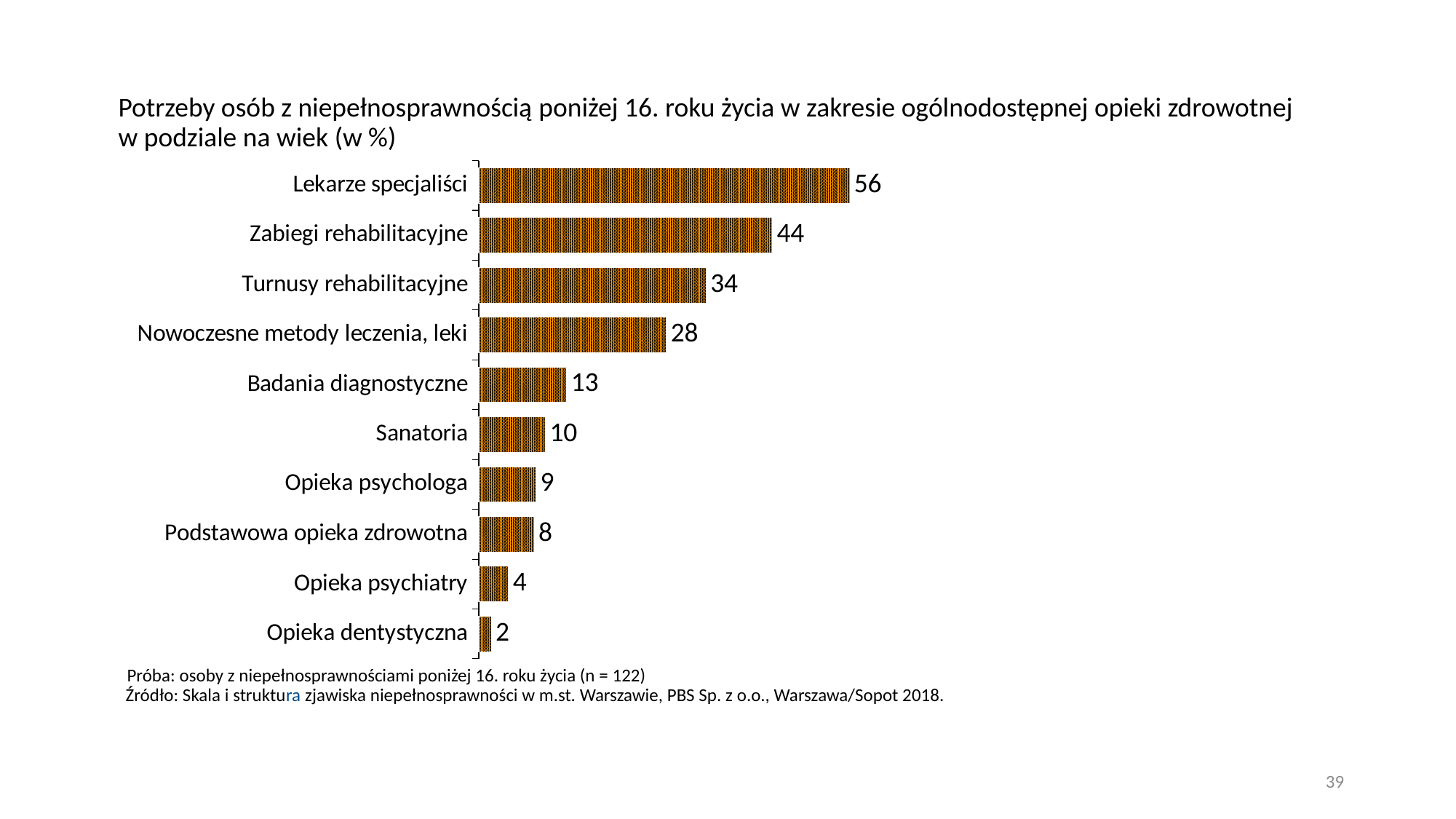
What is the sample size (n) given in the note below the chart? 122 Which category has the lowest value? Opieka dentystyczna What is the value for Nowoczesne metody leczenia, leki? 28 What is the difference between the values for Zabiegi rehabilitacyjne and Turnusy rehabilitacyjne? 10 Which is larger, the value for Podstawowa opieka zdrowotna or the value for Opieka psychiatry? Podstawowa opieka zdrowotna What is the difference between the values for Badania diagnostyczne and Sanatoria? 3 What kind of chart is shown on the slide? bar chart What is the value for Opieka psychologa? 9 Which category has the highest value? Lekarze specjaliści What is the value for Opieka psychiatry? 4 How many categories are shown in the chart? 10 What is the value for Lekarze specjaliści? 56